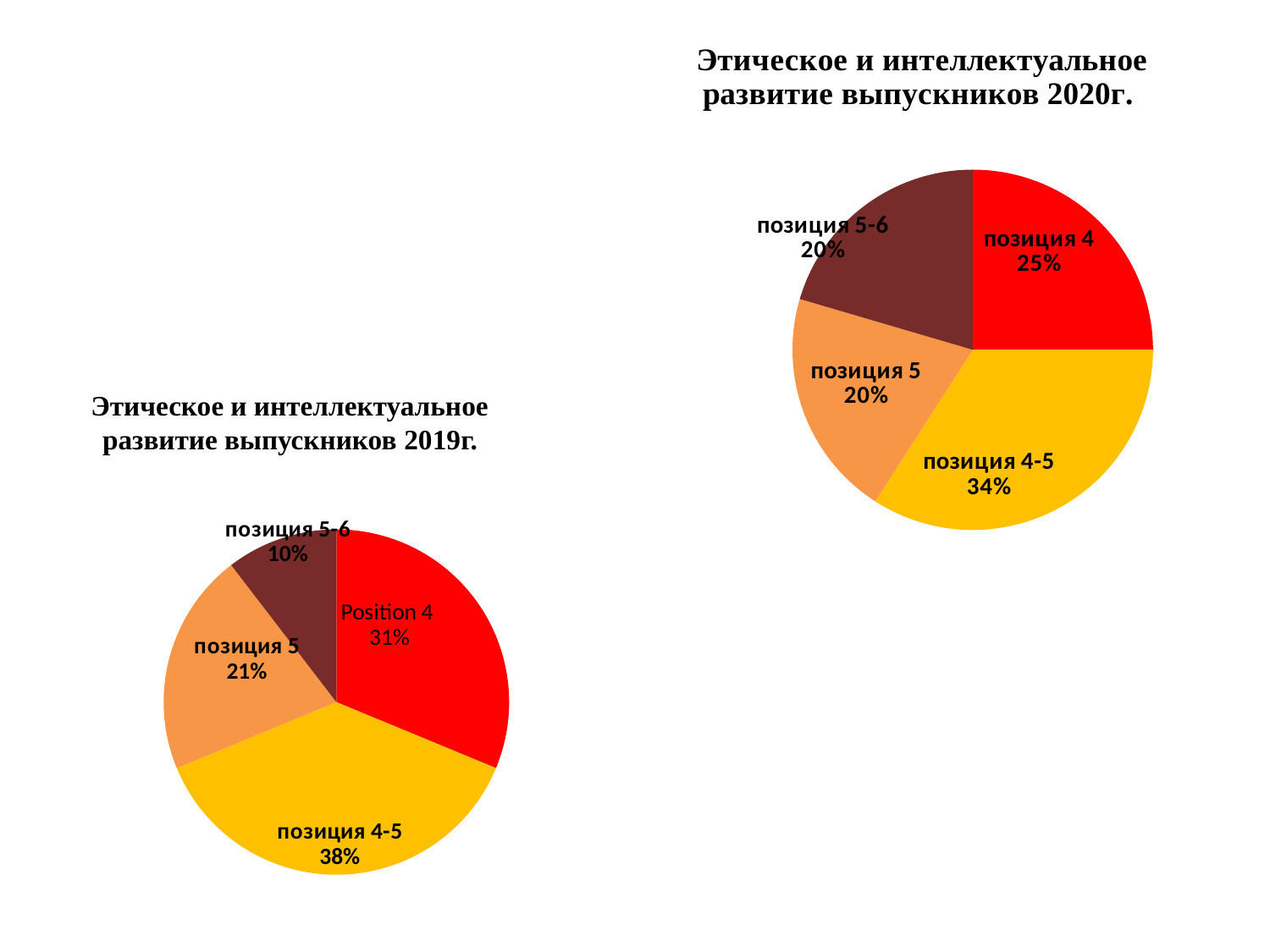
In the 2019 chart, which is larger: Position 4 or позиция 5? Position 4 In the 2020 chart, what share does позиция 5 have? 20% How many slices does the 2020 chart have? 4 In the 2020 chart, which slice is the largest? позиция 4-5 In the 2019 chart, what share does позиция 5-6 have? 10% In the 2019 chart (Этическое и интеллектуальное развитие выпускников 2019г.), what share does позиция 4-5 have? 38% In the 2019 chart, what is the difference between the shares of позиция 4-5 and Position 4? 7% In the 2019 chart, which slice is the largest? позиция 4-5 What type of chart is used for the 2019 data? Pie chart In the 2019 chart, which slice is the smallest? позиция 5-6 In the 2020 chart, what is the difference between the shares of позиция 4-5 and позиция 4? 9% In the 2020 chart (Этическое и интеллектуальное развитие выпускников 2020г.), what share does позиция 4 have? 25%